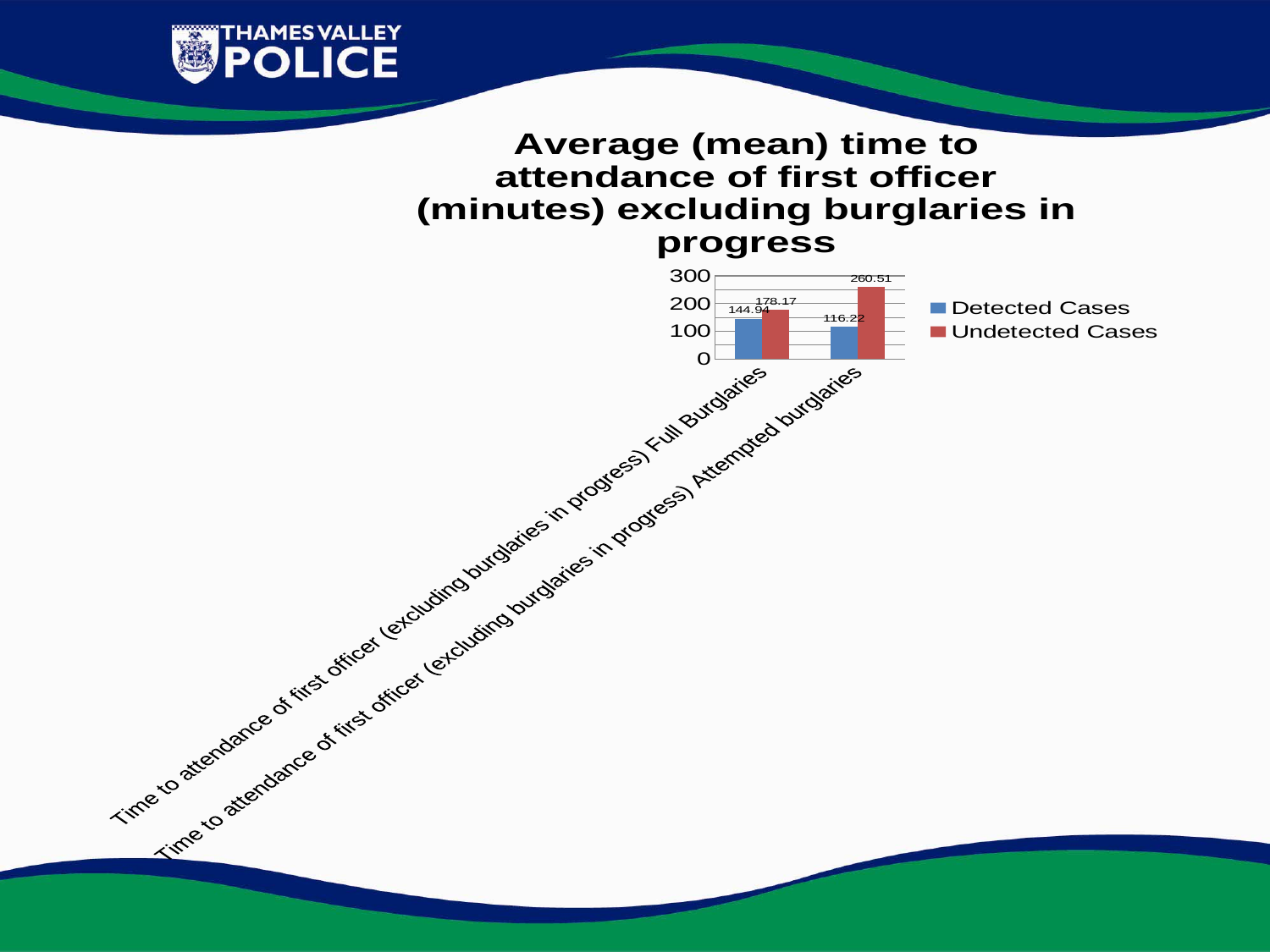
What is the value for Undetected Cases for Attempted burglaries? 260.51 What is the difference between Undetected Cases and Detected Cases for Full Burglaries? 33.23 What is the value for Detected Cases for Full Burglaries? 144.94 What colour represents Undetected Cases in the chart? Red Which bar has the lowest value on the chart? Detected Cases, Attempted burglaries What is the value for Undetected Cases for Full Burglaries? 178.17 Which bar has the highest value on the chart? Undetected Cases, Attempted burglaries What is the difference between Undetected Cases and Detected Cases for Attempted burglaries? 144.29 What is the value for Detected Cases for Attempted burglaries? 116.22 How many series does the legend list? 2 Which is larger for Full Burglaries: Detected Cases or Undetected Cases? Undetected Cases What kind of chart is shown on the slide? Bar chart